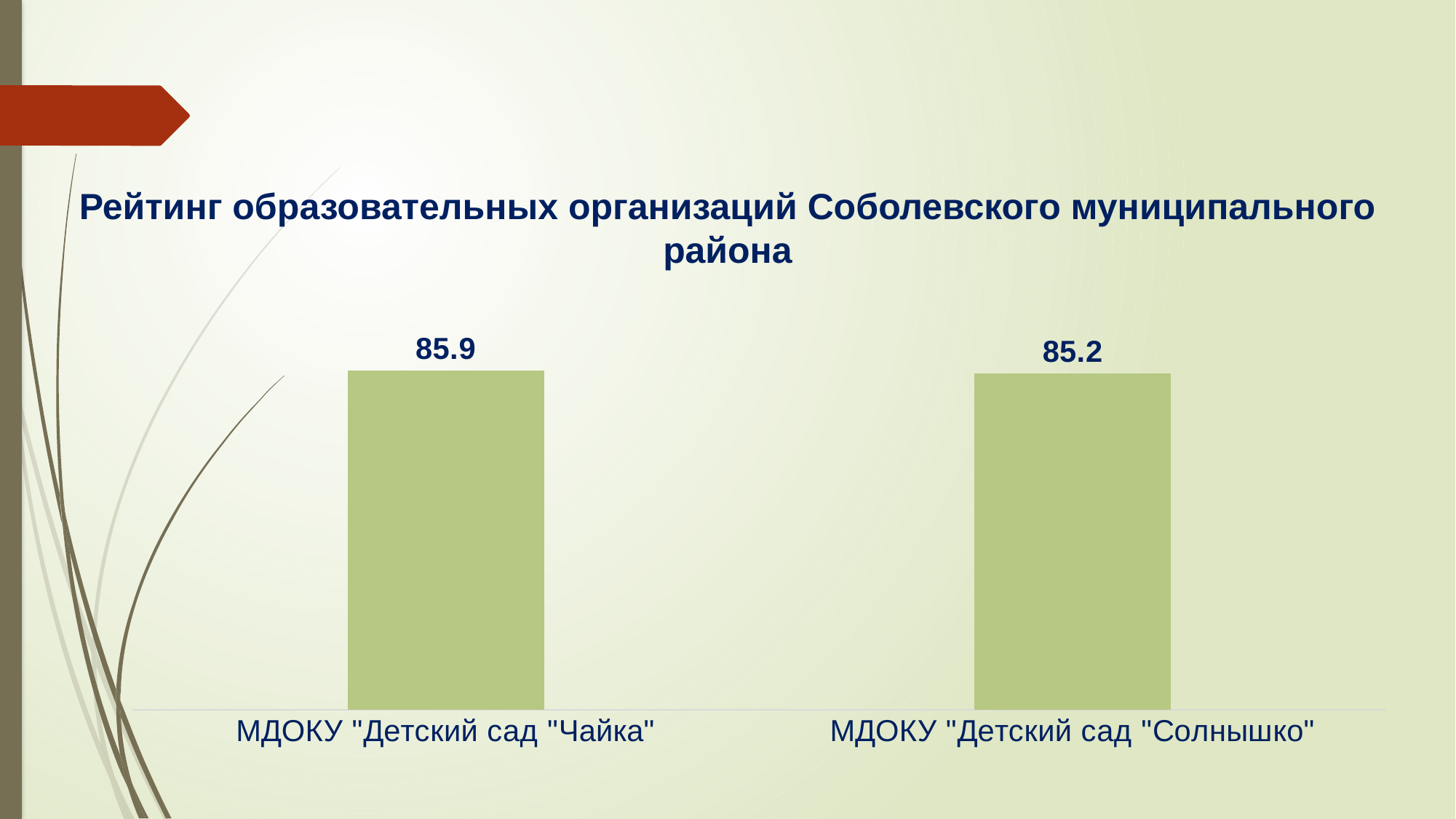
What colour are the bars in the chart? Green Which has a larger value, МДОКУ "Детский сад "Чайка" or МДОКУ "Детский сад "Солнышко"? МДОКУ "Детский сад "Чайка" Which category has the lowest value? МДОКУ "Детский сад "Солнышко" What is the value for МДОКУ "Детский сад "Солнышко"? 85.2 What kind of chart is shown on the slide? Bar chart What is the difference between the values for МДОКУ "Детский сад "Чайка" and МДОКУ "Детский сад "Солнышко"? 0.7 How many categories are shown in the chart? 2 What is the title of the slide? Рейтинг образовательных организаций Соболевского муниципального района Which category has the highest value? МДОКУ "Детский сад "Чайка" What is the value for МДОКУ "Детский сад "Чайка"? 85.9